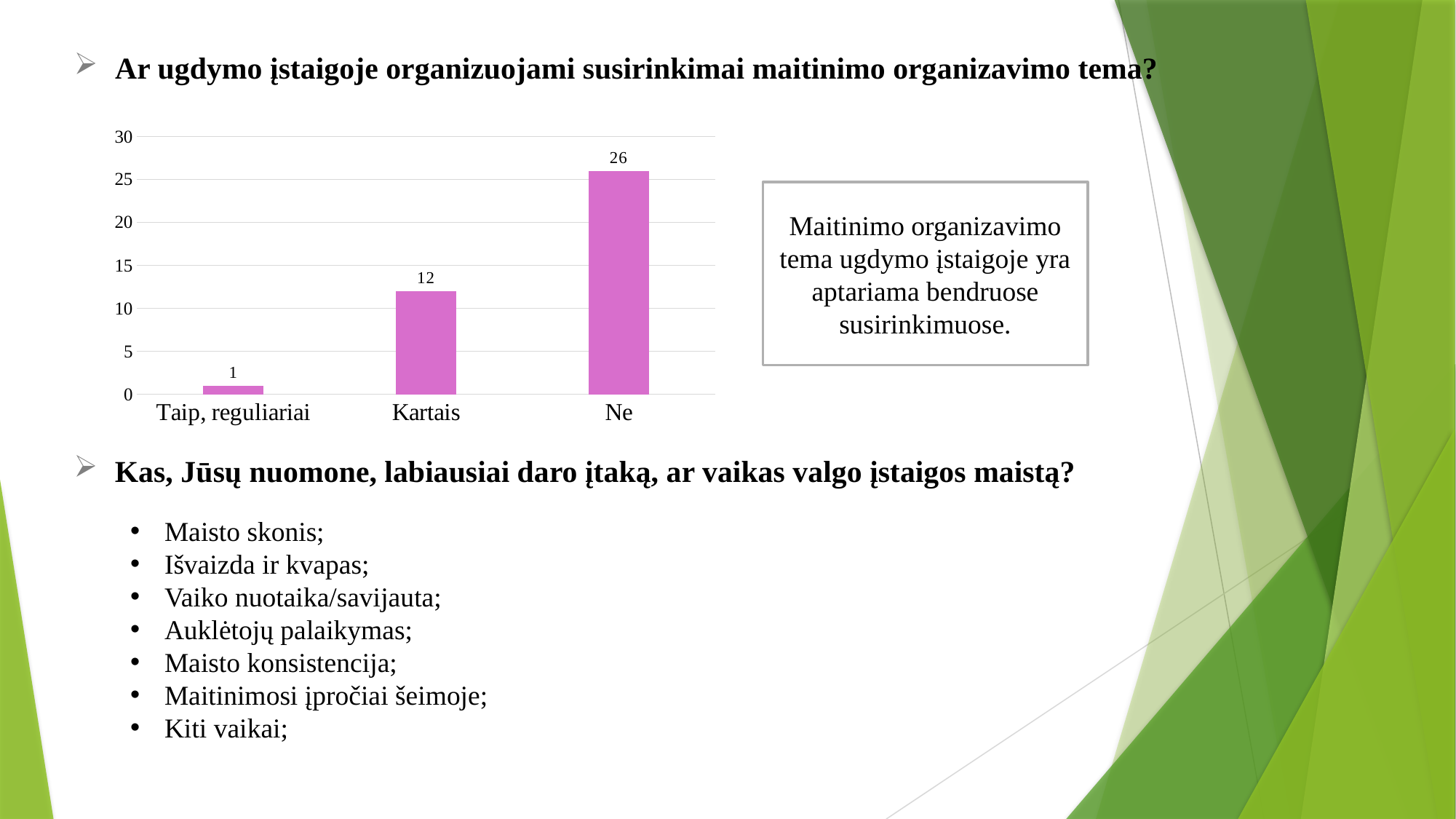
What is the value for "Ne"? 26 Is the value for "Ne" greater or less than 20? greater Which category has the lowest value? Taip, reguliariai Do the values rise or fall from left to right along the x axis? rise What is the difference between the values for "Ne" and "Kartais"? 14 What kind of chart is shown on the slide? bar chart Which is larger, the value for "Kartais" or the value for "Taip, reguliariai"? Kartais How many categories are shown on the x axis? 3 What is the value for "Kartais"? 12 What is the value for "Taip, reguliariai"? 1 What is the difference between the values for "Kartais" and "Taip, reguliariai"? 11 Which category has the highest value? Ne